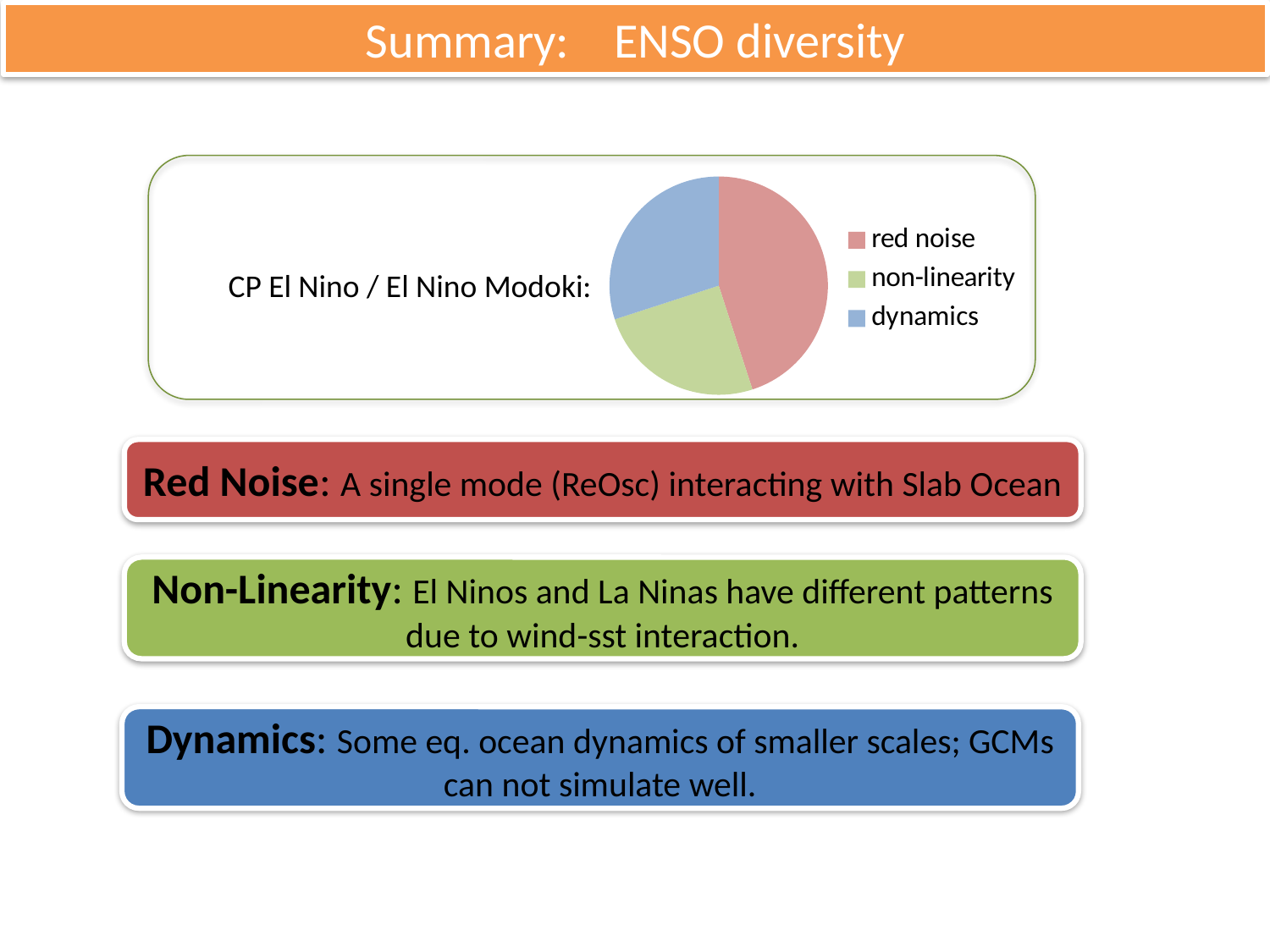
What text label appears to the left of the pie chart? CP El Nino / El Nino Modoki: Which slice is larger in the pie chart, red noise or non-linearity? red noise Which slice is larger in the pie chart, red noise or dynamics? red noise Which category has the largest slice in the pie chart? red noise How many entries does the legend of the pie chart list? 3 What colour is the red noise slice in the pie chart? red (pink) How many slices does the pie chart have? 3 What kind of chart is shown on the slide? pie chart Is the red noise slice greater or less than half of the pie? less